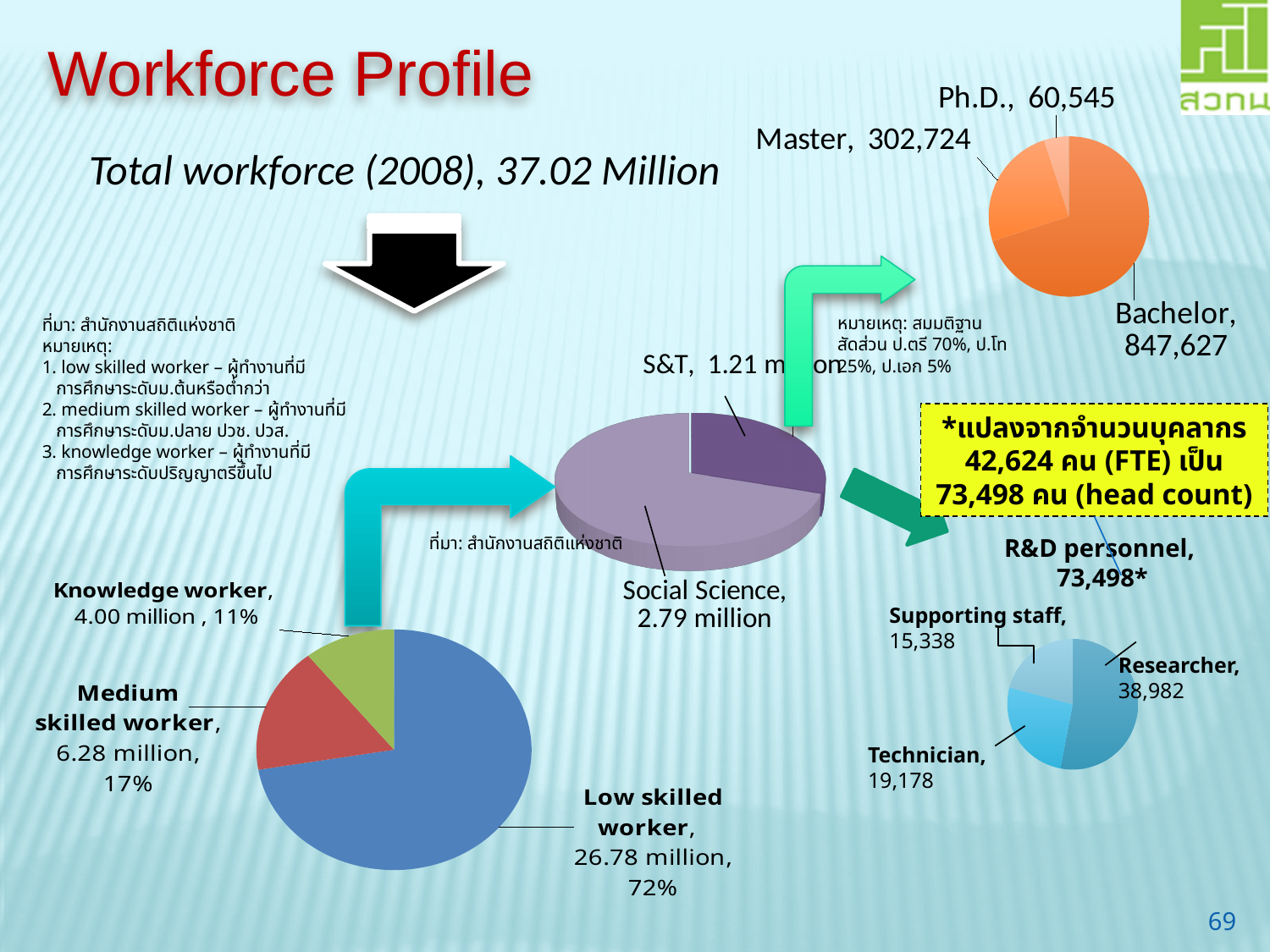
In the bottom-right R&D personnel pie chart, what is the value for Technician? 19,178 In the top-right pie chart of degree levels, which category is the largest? Bachelor In the top-right pie chart of degree levels, what is the difference between the Master and Ph.D. values? 242,179 How many slices does the bottom-left pie chart of the workforce by skill level have? 3 In the bottom-left pie chart of the workforce by skill level, what is the value for Low skilled worker? 26.78 million In the center pie chart, which is larger, S&T or Social Science? Social Science What kind of chart is the top-right chart of degree levels? Pie chart In the bottom-right R&D personnel pie chart, what is the total of all three categories? 73,498 In the bottom-right R&D personnel pie chart, which category is the smallest? Supporting staff In the bottom-left pie chart of the workforce by skill level, what share of the pie is Medium skilled worker? 17% In the top-right pie chart of degree levels, what is the value for Ph.D.? 60,545 In the bottom-right R&D personnel pie chart, what is the difference between Researcher and Technician? 19,804